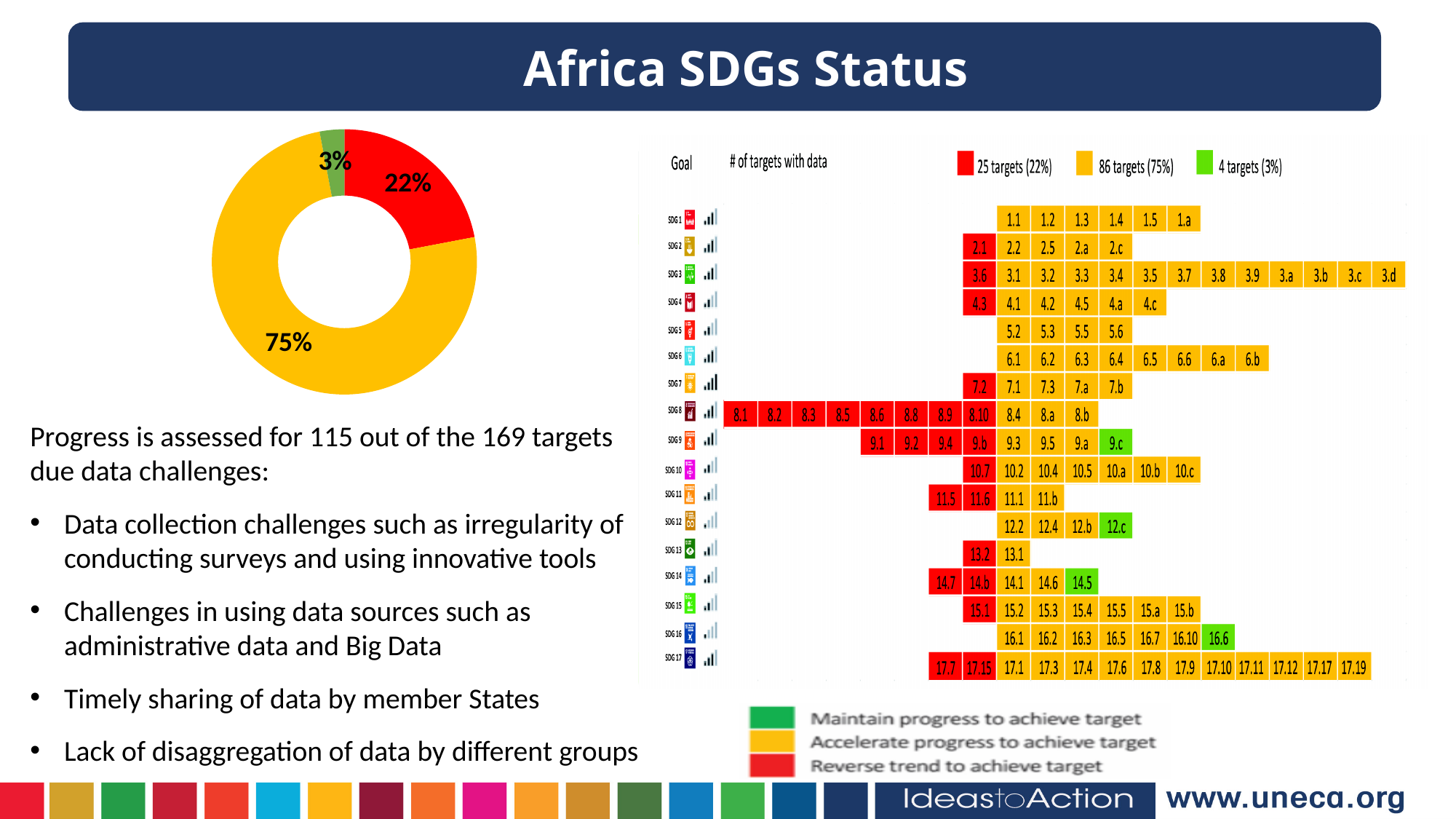
In the target grid on the right, which SDG has the most red (reverse trend) targets? SDG 8 According to the legend of the target grid on the right, how many targets correspond to the 22% share? 25 targets In the donut chart, which is larger: the red slice or the green slice? The red slice (22%) How many slices does the donut chart have? 3 In the donut chart, what percentage is shown for the red slice? 22% In the donut chart, what is the difference between the yellow slice and the red slice? 53 percentage points In the donut chart, which slice is the largest? The yellow slice (75%) What kind of chart is shown on the left of the slide? Donut (pie) chart In the donut chart, what percentage is shown for the green slice? 3% In the donut chart, what percentage is shown for the yellow slice? 75% In the donut chart, which slice is the smallest? The green slice (3%) According to the legend of the target grid on the right, what percentage corresponds to 86 targets? 75%